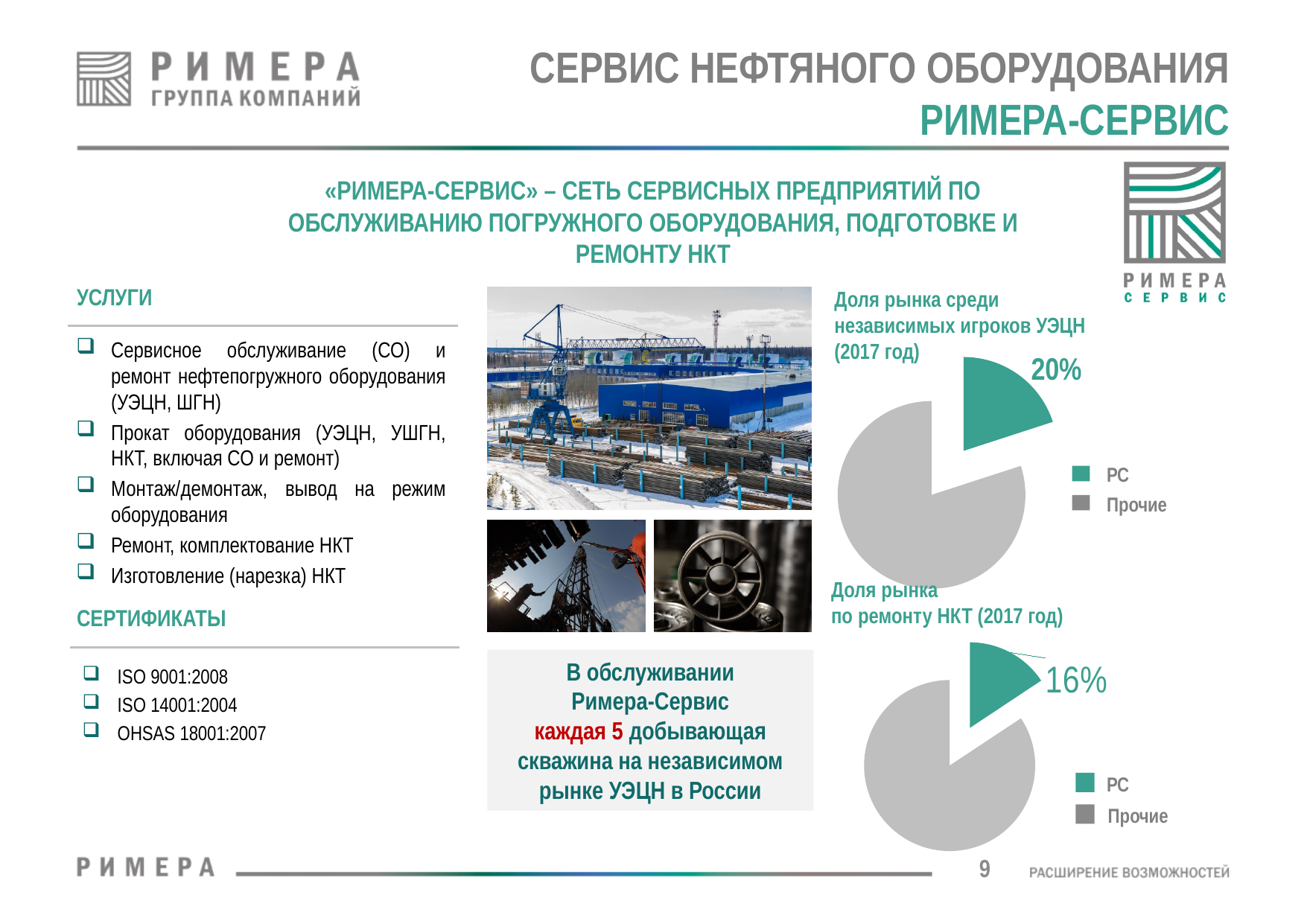
In the pie chart «Доля рынка среди независимых игроков УЭЦН (2017 год)», what colour is the РС slice? Teal (green) In the pie chart titled «Доля рынка среди независимых игроков УЭЦН (2017 год)», what share is shown for РС? 20% How many slices does the pie chart «Доля рынка по ремонту НКТ (2017 год)» have? 2 What are the two legend entries of the pie chart «Доля рынка по ремонту НКТ (2017 год)»? РС and Прочие How many categories does the legend of the pie chart «Доля рынка среди независимых игроков УЭЦН (2017 год)» list? 2 What type of chart is used for «Доля рынка по ремонту НКТ (2017 год)»? Pie chart What is the difference in percentage points between the РС share in the pie chart «Доля рынка среди независимых игроков УЭЦН (2017 год)» and the РС share in the pie chart «Доля рынка по ремонту НКТ (2017 год)»? 4 percentage points In the pie chart «Доля рынка среди независимых игроков УЭЦН (2017 год)», which slice is larger: РС or Прочие? Прочие In the pie chart «Доля рынка по ремонту НКТ (2017 год)», which slice is the smallest? РС Which is larger: the РС share in the pie chart «Доля рынка среди независимых игроков УЭЦН (2017 год)» or the РС share in the pie chart «Доля рынка по ремонту НКТ (2017 год)»? Доля рынка среди независимых игроков УЭЦН (2017 год) In the pie chart titled «Доля рынка по ремонту НКТ (2017 год)», what share is shown for РС? 16% What type of chart is used for «Доля рынка среди независимых игроков УЭЦН (2017 год)»? Pie chart